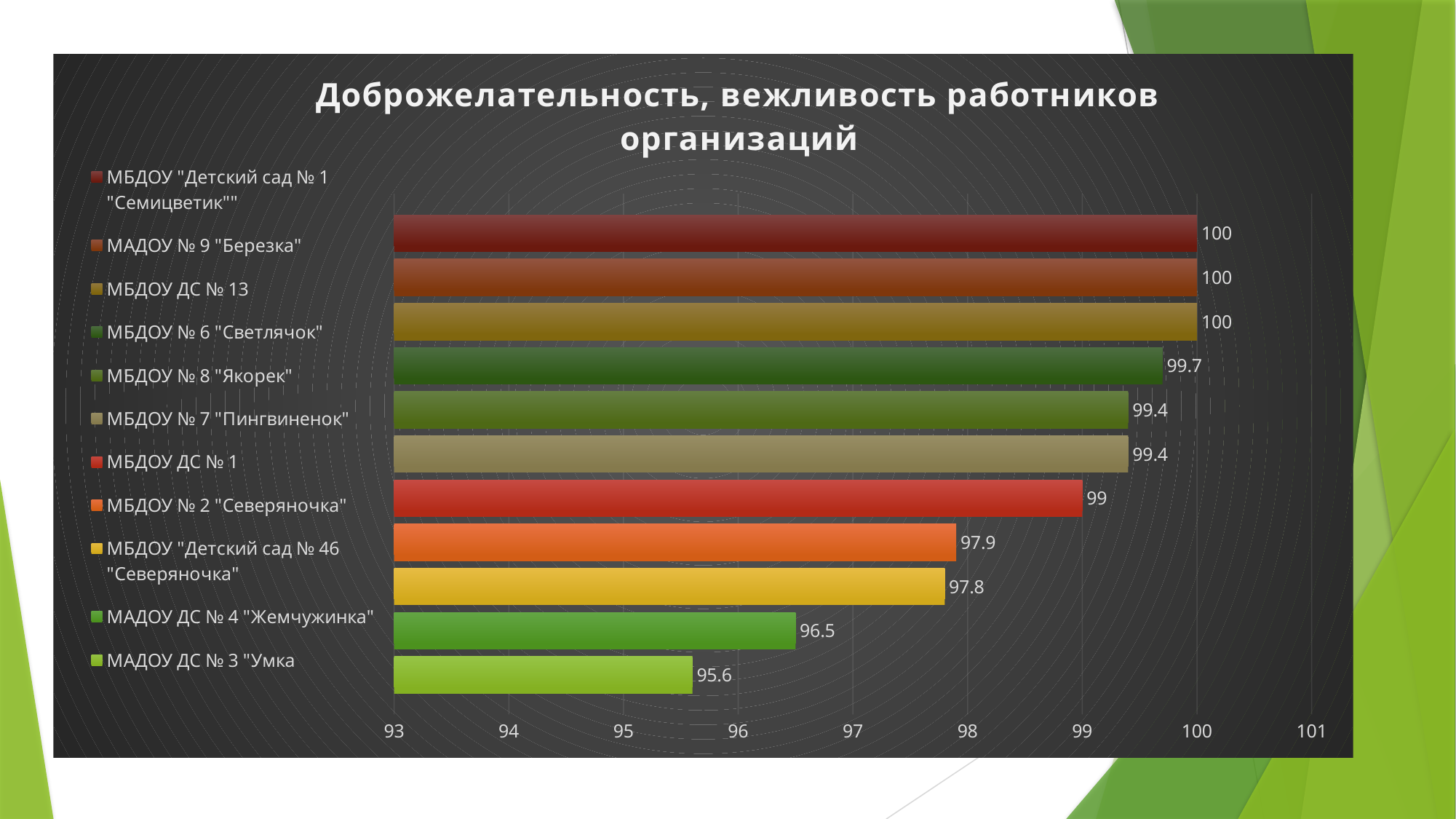
What kind of chart is shown on the slide? bar chart What is the value for МАДОУ ДС № 4 "Жемчужинка"? 96.5 What is the highest value shown on the chart? 100 What is the difference between the values for МБДОУ № 2 "Северяночка" and МАДОУ ДС № 3 "Умка"? 2.3 What is the value for МБДОУ № 6 "Светлячок"? 99.7 What is the title of the chart? Доброжелательность, вежливость работников организаций Which is larger, the value for МБДОУ № 8 "Якорек" or the value for МАДОУ ДС № 4 "Жемчужинка"? МБДОУ № 8 "Якорек" How many entries does the legend list? 11 What is the value for МАДОУ ДС № 3 "Умка"? 95.6 Which organization has the lowest value? МАДОУ ДС № 3 "Умка" What is the value for МБДОУ ДС № 1? 99 How many organizations (bars) are shown on the chart? 11